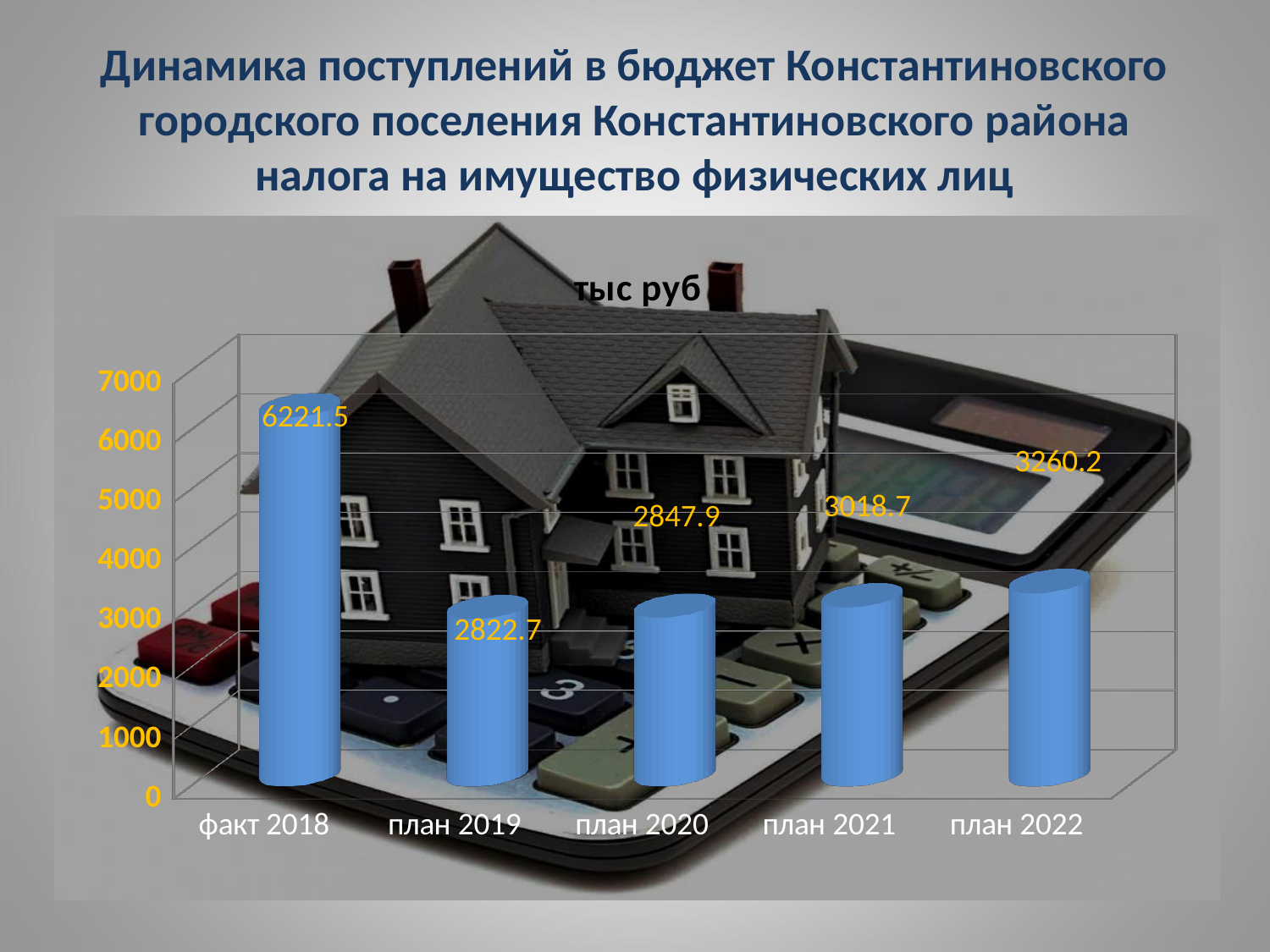
What is the value for план 2021? 3018.7 Which category has the highest value? факт 2018 What is the title shown above the chart? тыс руб What is the value for факт 2018? 6221.5 What kind of chart is shown on the slide? bar chart Is the value for факт 2018 greater or less than 6000? greater How many categories are shown on the x axis? 5 Which category has the lowest value? план 2019 What is the difference between the values for план 2022 and план 2021? 241.5 Which is larger, the value for план 2020 or the value for план 2022? план 2022 What is the value for план 2022? 3260.2 What is the difference between the values for факт 2018 and план 2019? 3398.8